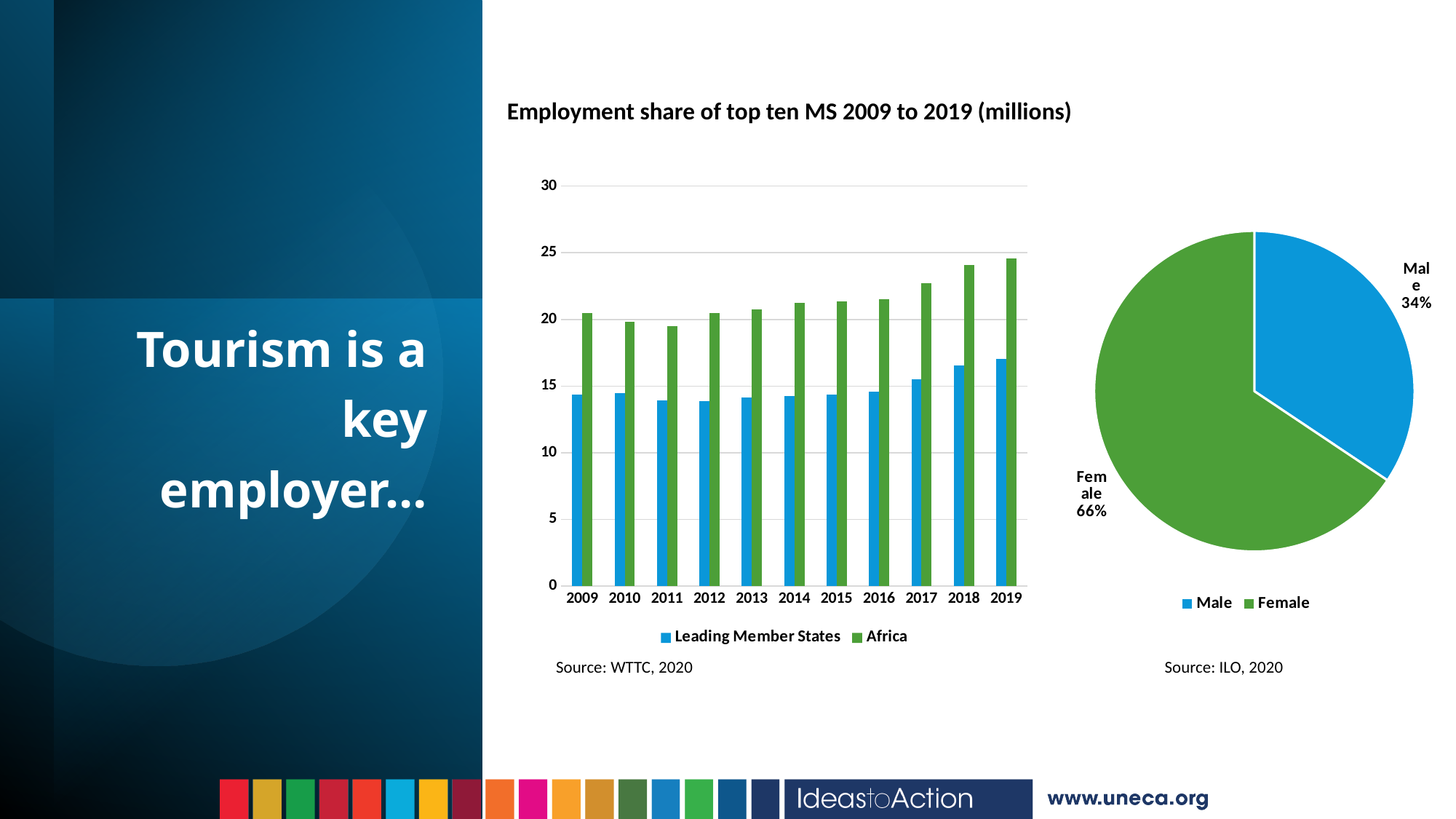
In the 'Employment share of top ten MS 2009 to 2019 (millions)' chart, which series has the larger value in 2009, Leading Member States or Africa? Africa In the 'Employment share of top ten MS 2009 to 2019 (millions)' chart, is the value for Leading Member States in 2019 greater or less than 20? less In the pie chart on the right, what share is Male? 34% What kind of chart is the 'Employment share of top ten MS 2009 to 2019 (millions)' chart? bar chart In the pie chart on the right, what is the difference in percentage points between the Female and Male shares? 32 percentage points In the 'Employment share of top ten MS 2009 to 2019 (millions)' chart, how many years are shown on the x axis? 11 In the pie chart on the right, what share is Female? 66% In the 'Employment share of top ten MS 2009 to 2019 (millions)' chart, which year has the highest value for Africa? 2019 In the 'Employment share of top ten MS 2009 to 2019 (millions)' chart, how many series does the legend list? 2 In the 'Employment share of top ten MS 2009 to 2019 (millions)' chart, do the values for Leading Member States rise or fall from 2016 to 2019? rise In the 'Employment share of top ten MS 2009 to 2019 (millions)' chart, is the value for Leading Member States in 2012 greater or less than 15? less In the 'Employment share of top ten MS 2009 to 2019 (millions)' chart, is the value for Africa in 2019 greater or less than 20? greater